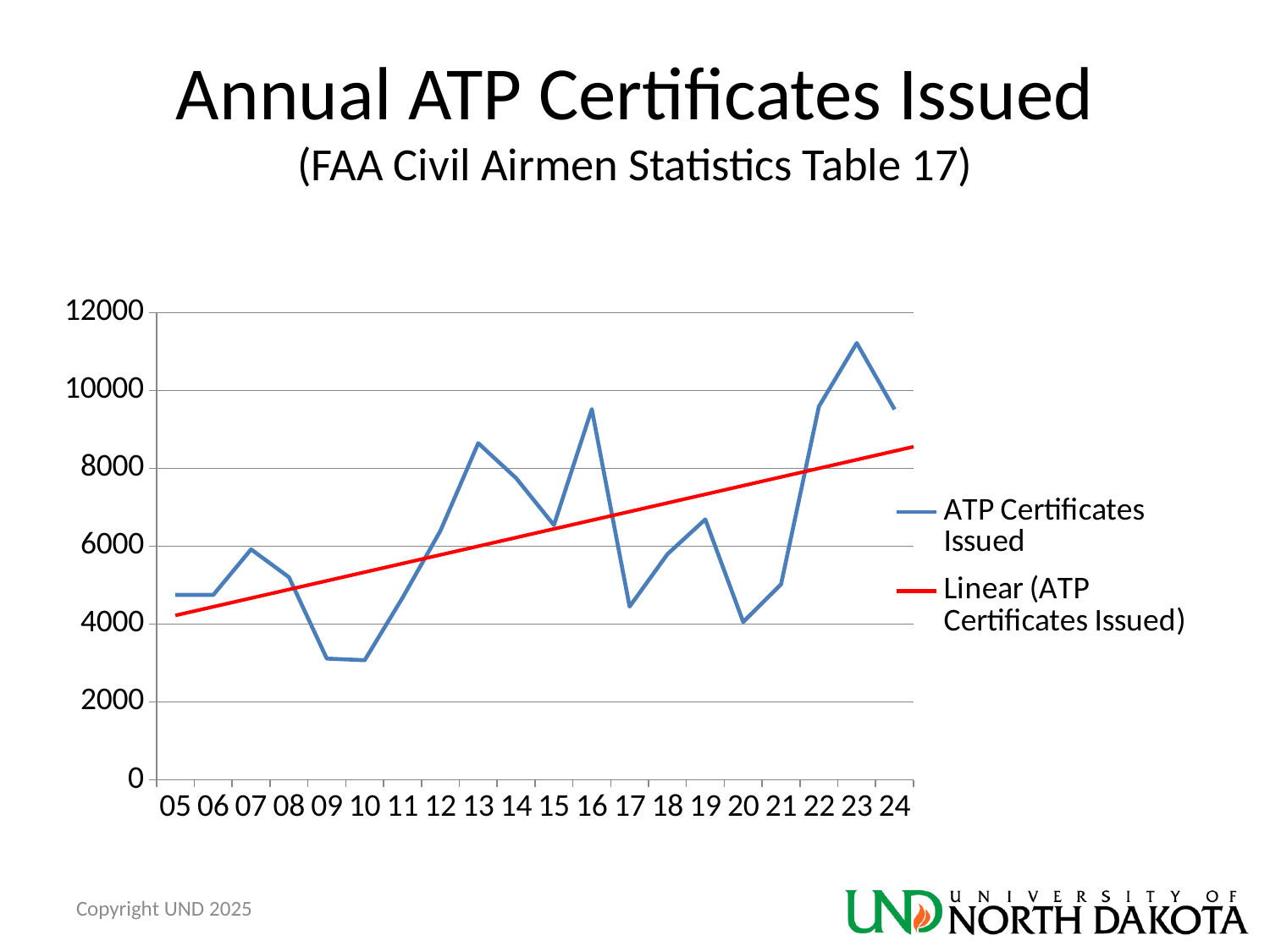
How many series does the legend list? 2 Is the value for ATP Certificates Issued in 23 greater or less than 10000? greater Is the value for ATP Certificates Issued in 09 greater or less than 4000? less What kind of chart is shown on the slide? line chart Which year has the larger number of ATP Certificates Issued, 21 or 22? 22 Which year has the highest number of ATP Certificates Issued? 23 How many years are plotted along the x axis? 20 What is the title of the chart? Annual ATP Certificates Issued (FAA Civil Airmen Statistics Table 17) Does the red linear trend line rise or fall from 05 to 24? rise Is the value for ATP Certificates Issued in 16 greater or less than 8000? greater Which year has the larger number of ATP Certificates Issued, 16 or 17? 16